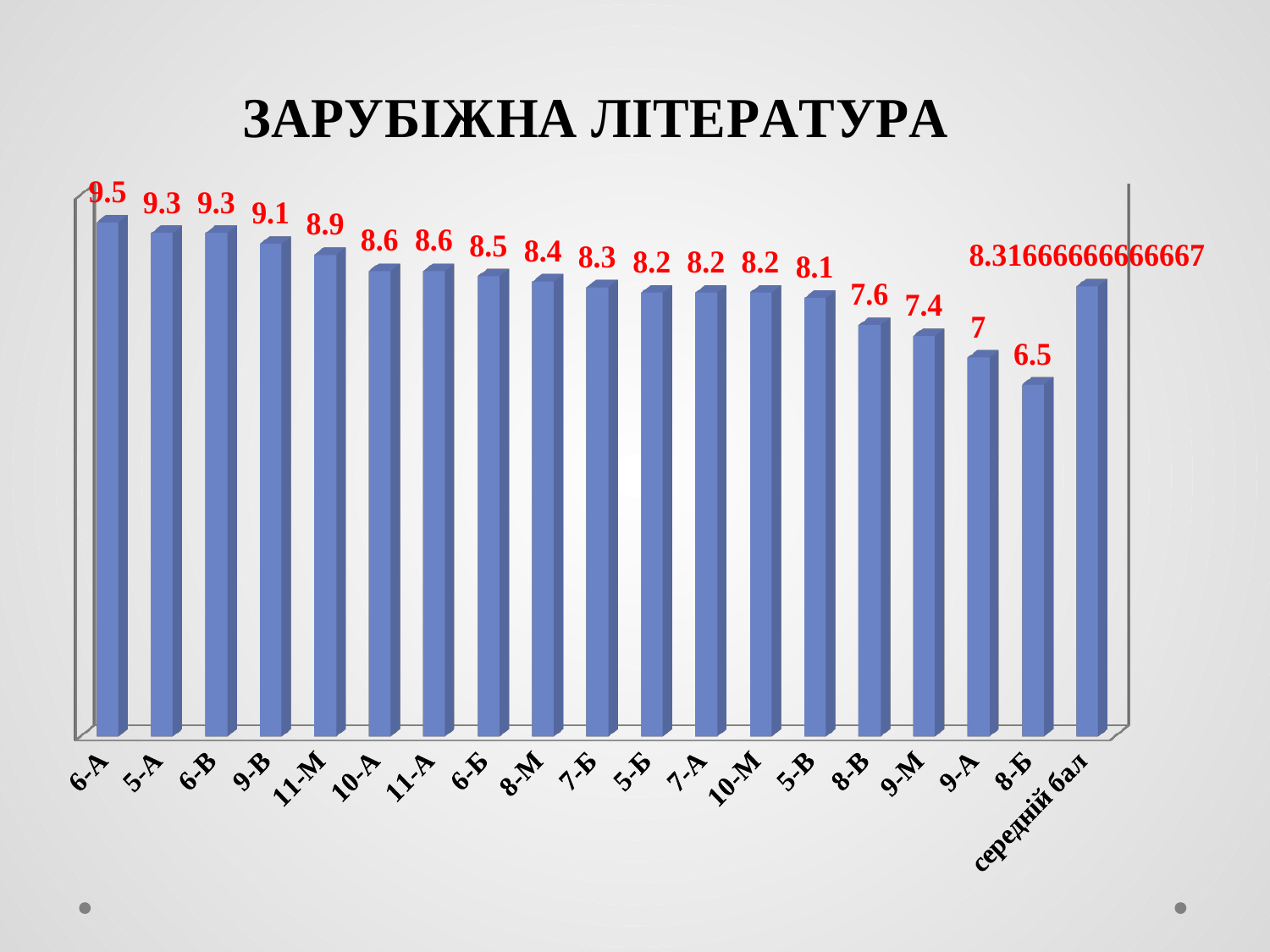
Which category has the highest value? 6-А Which category has the lowest value? 8-Б What is the value for 9-М? 7.4 How many bars are shown in the chart? 19 What is the difference between the values for 6-А and 8-Б? 3 What is the value shown for середній бал? 8.31666666666667 What is the difference between the values for 9-В and 8-В? 1.5 What is the value for 6-А? 9.5 What kind of chart is shown on the slide? Bar chart What is the value for 8-Б? 6.5 What is the title of the chart? ЗАРУБІЖНА ЛІТЕРАТУРА Which is larger, the value for 11-М or the value for 10-А? 11-М